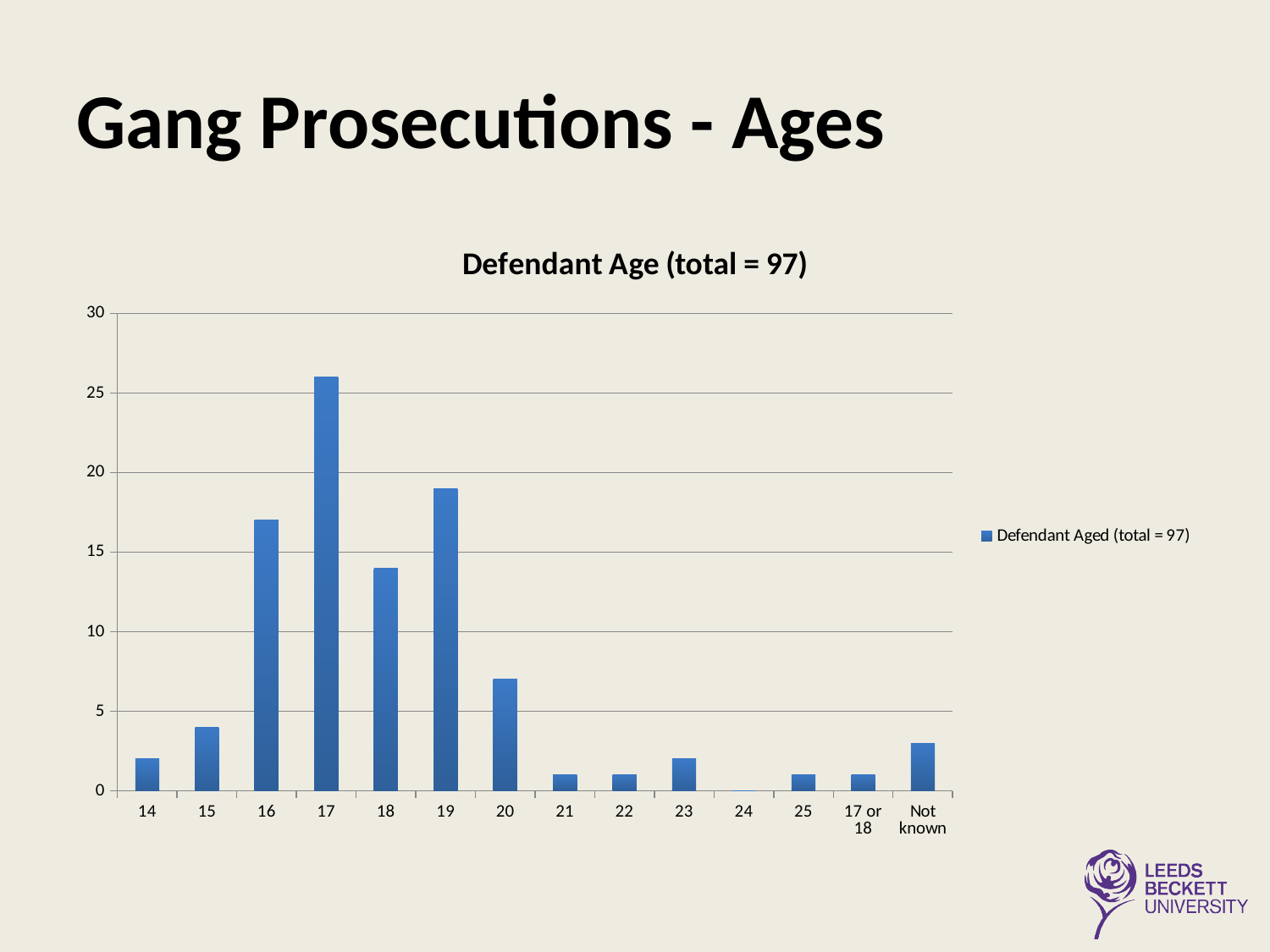
What type of chart is shown on the slide? bar chart Is the value for age 18 greater or less than 15? less Is the value for age 16 greater or less than 15? greater How many series does the legend list? 1 Which age category has the highest number of defendants? 17 Is the value for age 19 greater or less than 20? less How many age categories are shown on the x axis? 14 What is the title of the chart? Defendant Age (total = 97) Which has more defendants, age 20 or age 15? 20 Which has more defendants, age 16 or age 18? 16 Which age category has the lowest number of defendants? 24